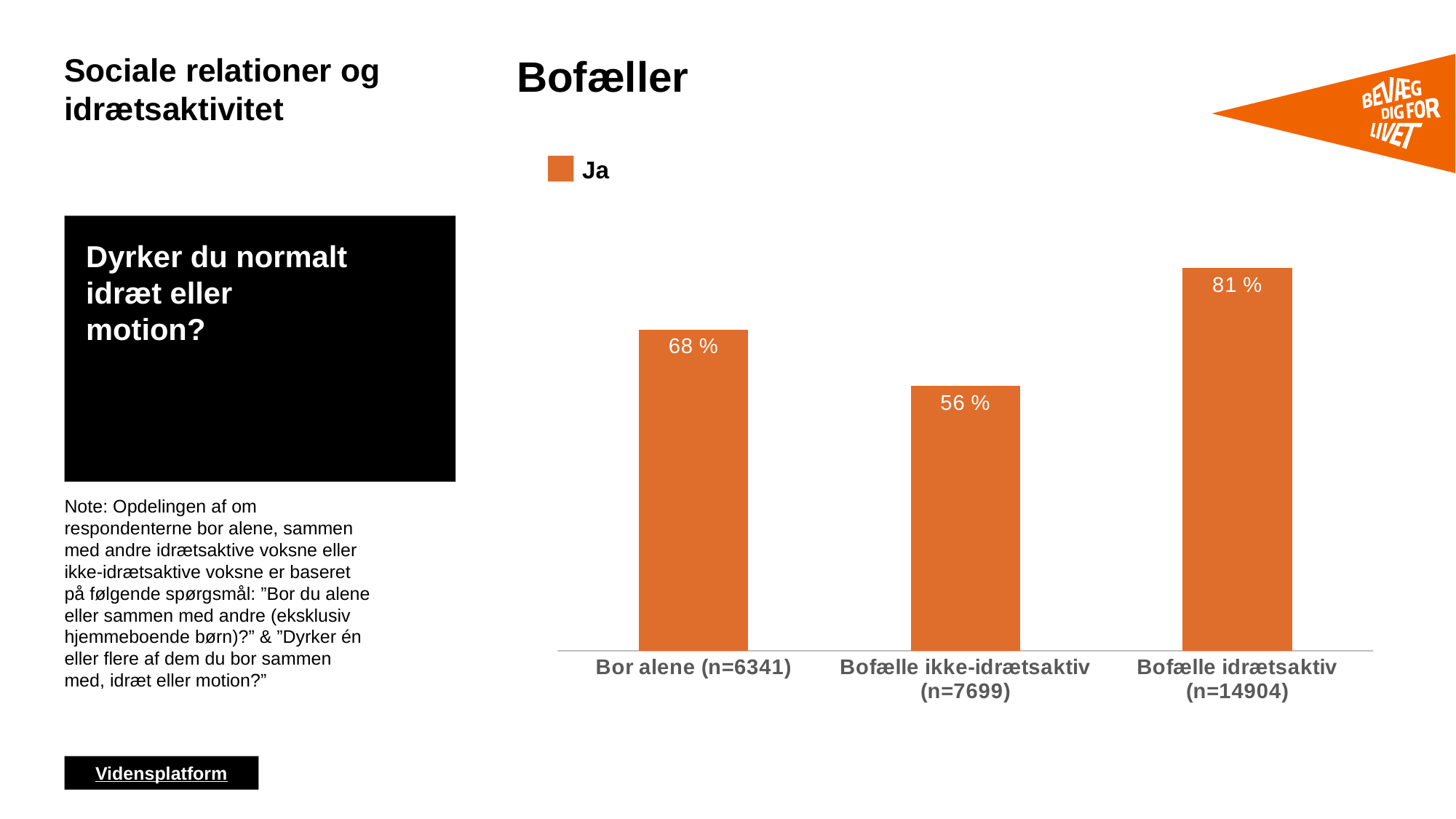
What is the title of the chart? Bofæller What is the difference between the values for 'Bor alene' and 'Bofælle ikke-idrætsaktiv'? 12 percentage points How many categories are shown in the chart? 3 How many series does the legend list? 1 What type of chart is shown on the slide? Bar chart What is the difference between the values for 'Bofælle idrætsaktiv' and 'Bofælle ikke-idrætsaktiv'? 25 percentage points Which category has the lowest value in the chart? Bofælle ikke-idrætsaktiv (n=7699) Which category has the highest value in the chart? Bofælle idrætsaktiv (n=14904) What percentage of respondents who live alone (Bor alene) answered 'Ja'? 68 % What is the value shown for 'Bofælle idrætsaktiv'? 81 % Which is larger: the value for 'Bor alene' or the value for 'Bofælle idrætsaktiv'? Bofælle idrætsaktiv What is the value shown for 'Bofælle ikke-idrætsaktiv'? 56 %